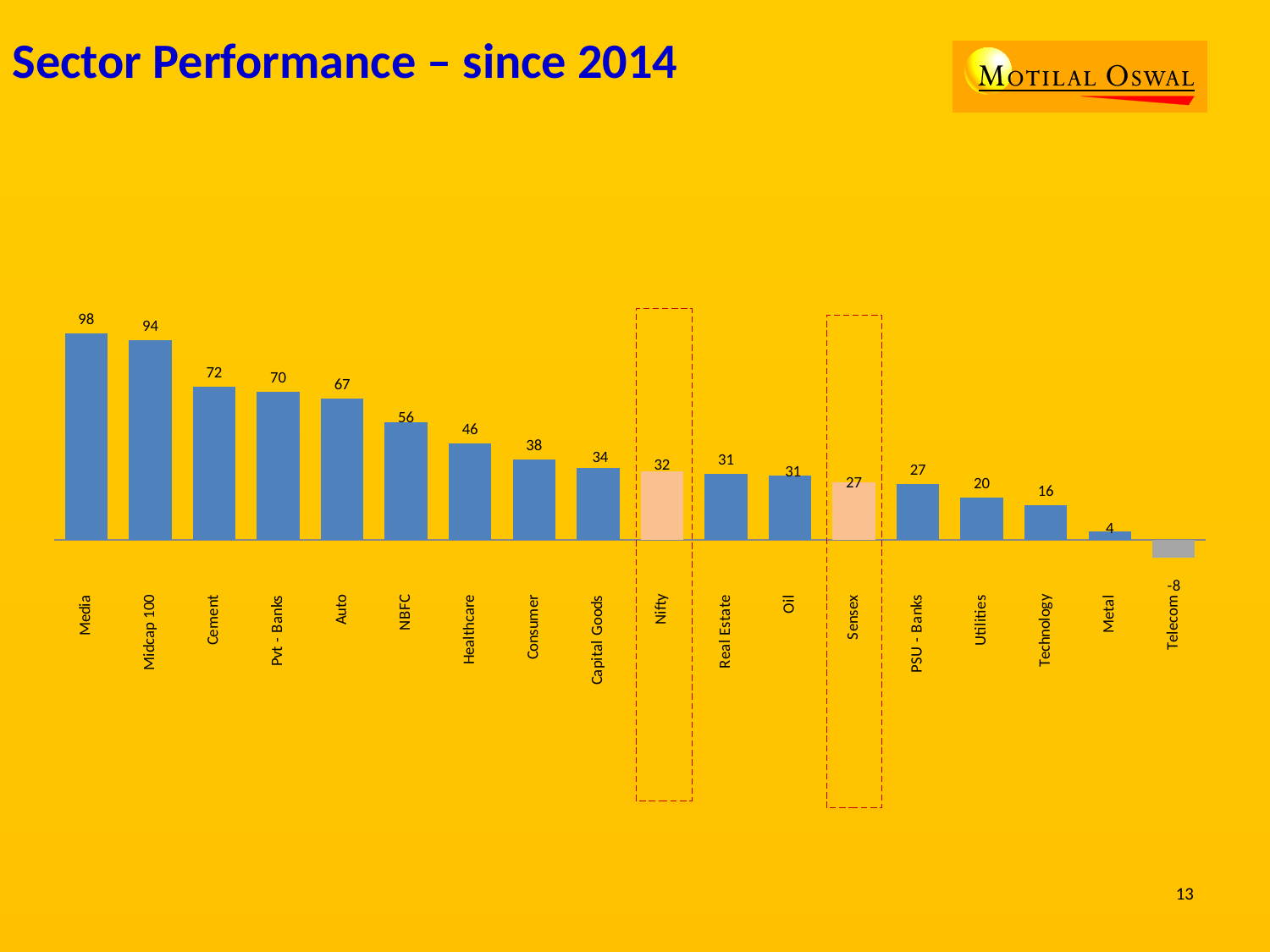
Do the values rise or fall from left to right across the chart? Fall What is the value for Media? 98 What is the difference between the values for Media and Midcap 100? 4 What is the difference between the values for Nifty and Sensex? 5 Which is larger, the value for Cement or the value for NBFC? Cement How many categories are shown in the chart? 18 Which category has the lowest value? Telecom Which sector has the highest value? Media What kind of chart is shown on the slide? Bar chart What is the value for Nifty? 32 What is the value for Telecom? -8 What is the value for Sensex? 27